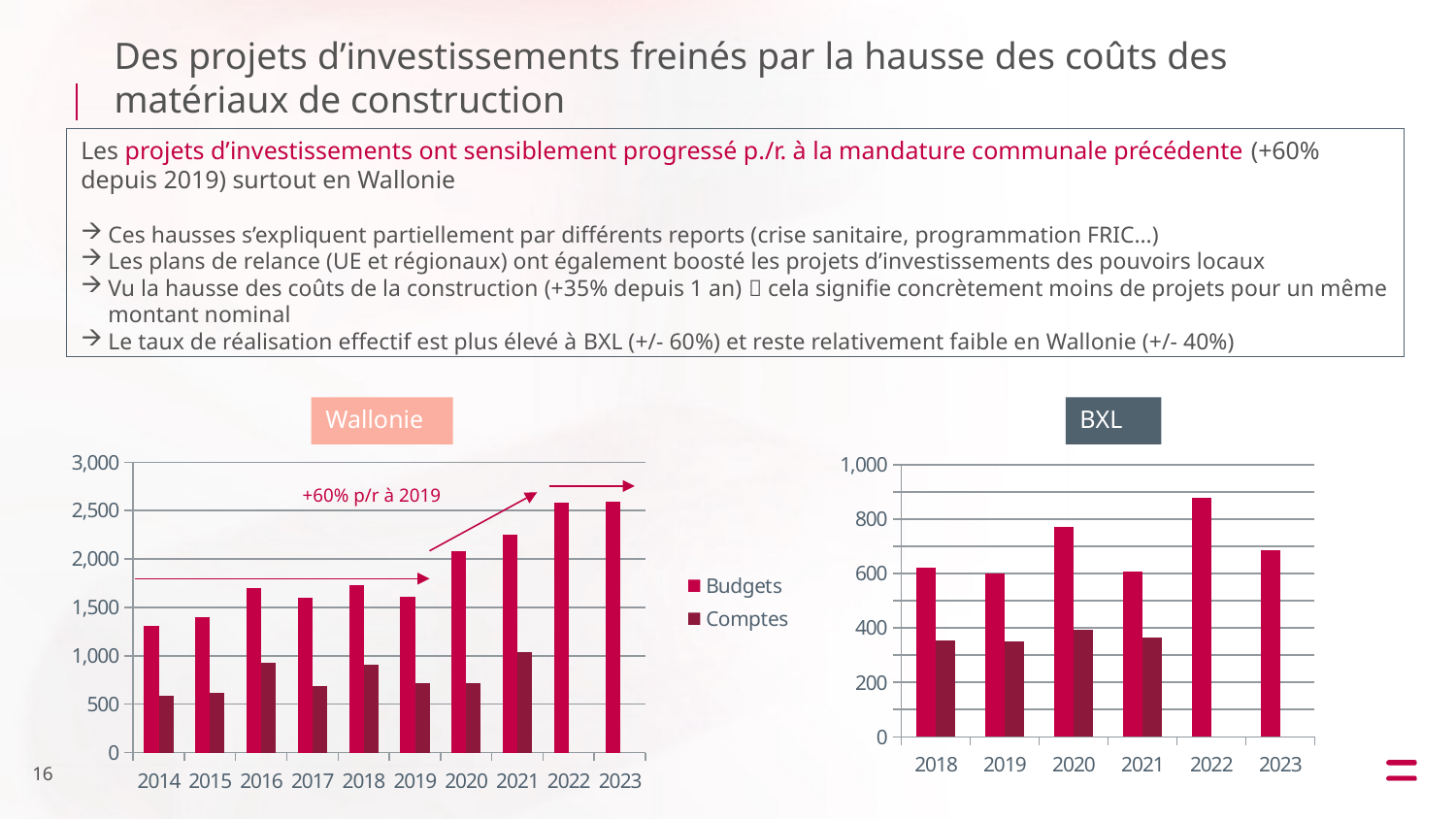
What kind of chart is the Wallonie chart? bar chart How many years are shown on the x axis of the BXL chart? 6 In the BXL chart, which is larger, the Budgets value for 2020 or for 2023? 2020 How many years are shown on the x axis of the Wallonie chart? 10 How many series does the legend list? 2 In the BXL chart, is the Budgets value for 2020 greater or less than 800? less In the Wallonie chart, is the Budgets value for 2020 greater or less than 2,000? greater In the BXL chart, which year has the highest Comptes value? 2020 In the Wallonie chart, which year has the lowest Budgets value? 2014 In the Wallonie chart, do the Budgets values rise or fall from 2019 to 2023? rise In the Wallonie chart, which year has the highest Comptes value? 2021 In the BXL chart, which year has the highest Budgets value? 2022